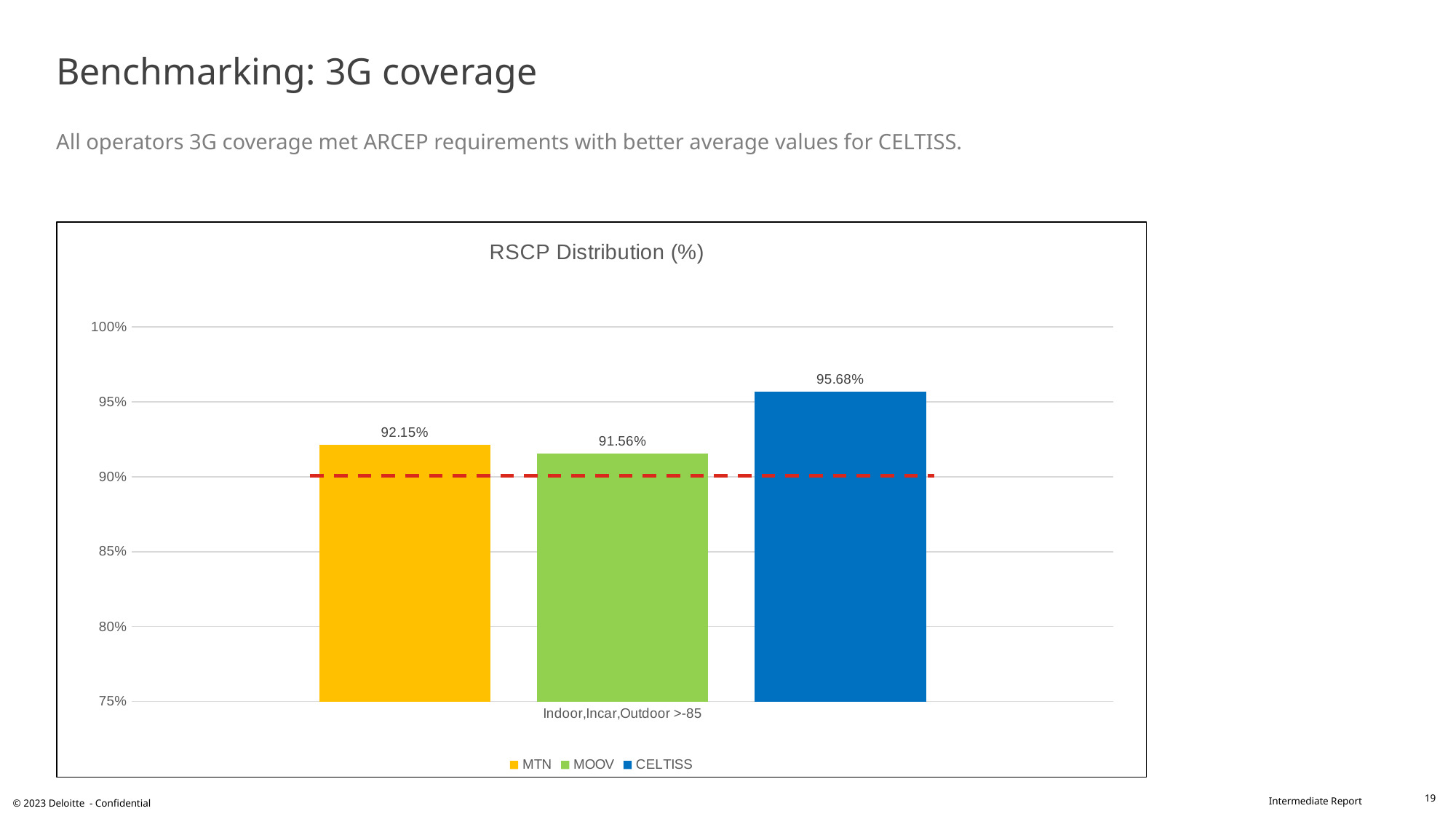
How many series does the legend list? 3 Which operator has the lowest RSCP Distribution value? MOOV What is the difference between the MTN and MOOV values? 0.59% What kind of chart is shown on the slide? Bar chart Which operator has the highest RSCP Distribution value? CELTISS What is the RSCP Distribution value for CELTISS? 95.68% Is the value for MOOV greater or less than 90%? greater What is the difference between the CELTISS and MTN values? 3.53% What is the title of the chart? RSCP Distribution (%) Which is larger, the value for CELTISS or the value for MOOV? CELTISS What is the RSCP Distribution value for MTN? 92.15% What is the RSCP Distribution value for MOOV? 91.56%